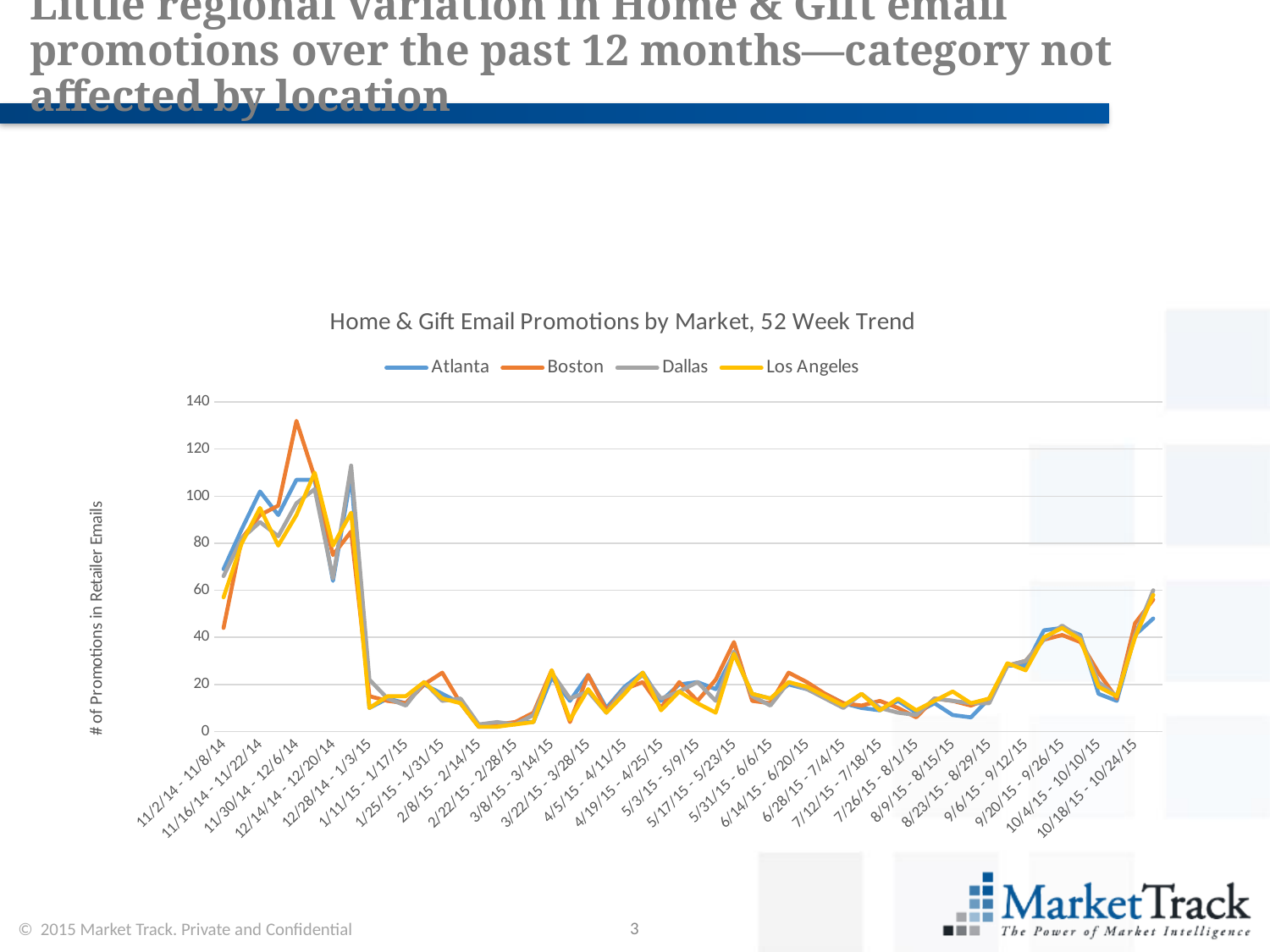
How many series does the legend list? 4 What is the label on the vertical axis? # of Promotions in Retailer Emails What is the title of the chart? Home & Gift Email Promotions by Market, 52 Week Trend Is the value for Boston in the week 11/2/14 - 11/8/14 greater or less than 60? less Which market has the lowest value in the week 11/2/14 - 11/8/14? Boston Is the peak value for Boston greater or less than 120? greater What kind of chart is shown on the slide? Line chart Is the value for Dallas in the week 1/11/15 - 1/17/15 greater or less than 40? less In the week 11/2/14 - 11/8/14, which is larger, the value for Atlanta or the value for Boston? Atlanta Which market's line reaches the highest peak on the chart? Boston